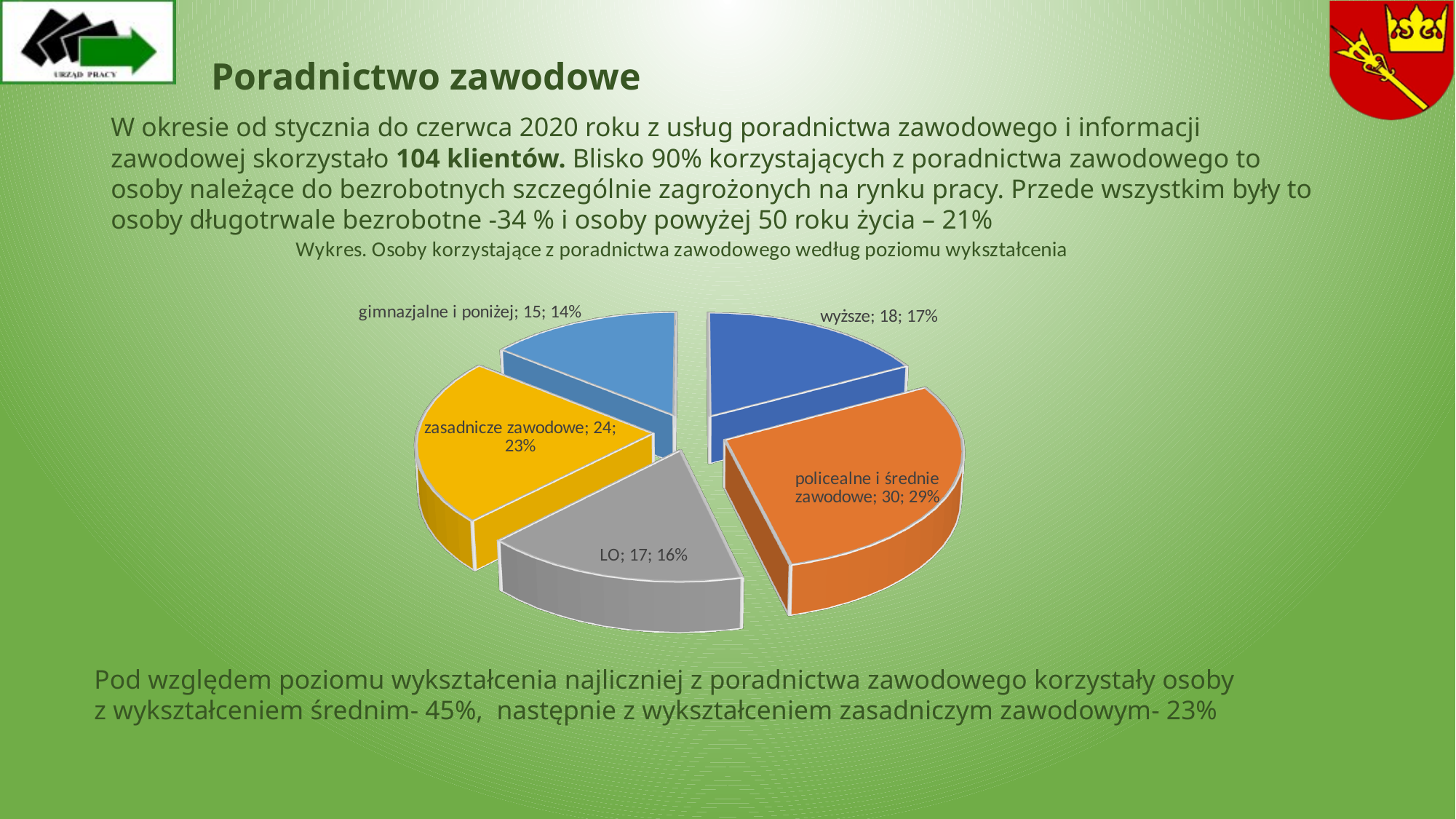
What is the value for 'policealne i średnie zawodowe'? 30 How many slices does the pie chart have? 5 Which category has the largest slice? policealne i średnie zawodowe What is the title of the chart? Wykres. Osoby korzystające z poradnictwa zawodowego według poziomu wykształcenia What share of the pie does 'zasadnicze zawodowe' represent? 23% What percentage is shown for 'wyższe'? 17% Which category has the smallest slice? gimnazjalne i poniżej What is the total of all the values shown in the pie chart? 104 What is the difference between the values for 'policealne i średnie zawodowe' and 'LO'? 13 Which is larger, the value for 'zasadnicze zawodowe' or the value for 'wyższe'? zasadnicze zawodowe What is the value for 'gimnazjalne i poniżej'? 15 What kind of chart is shown on the slide? pie chart